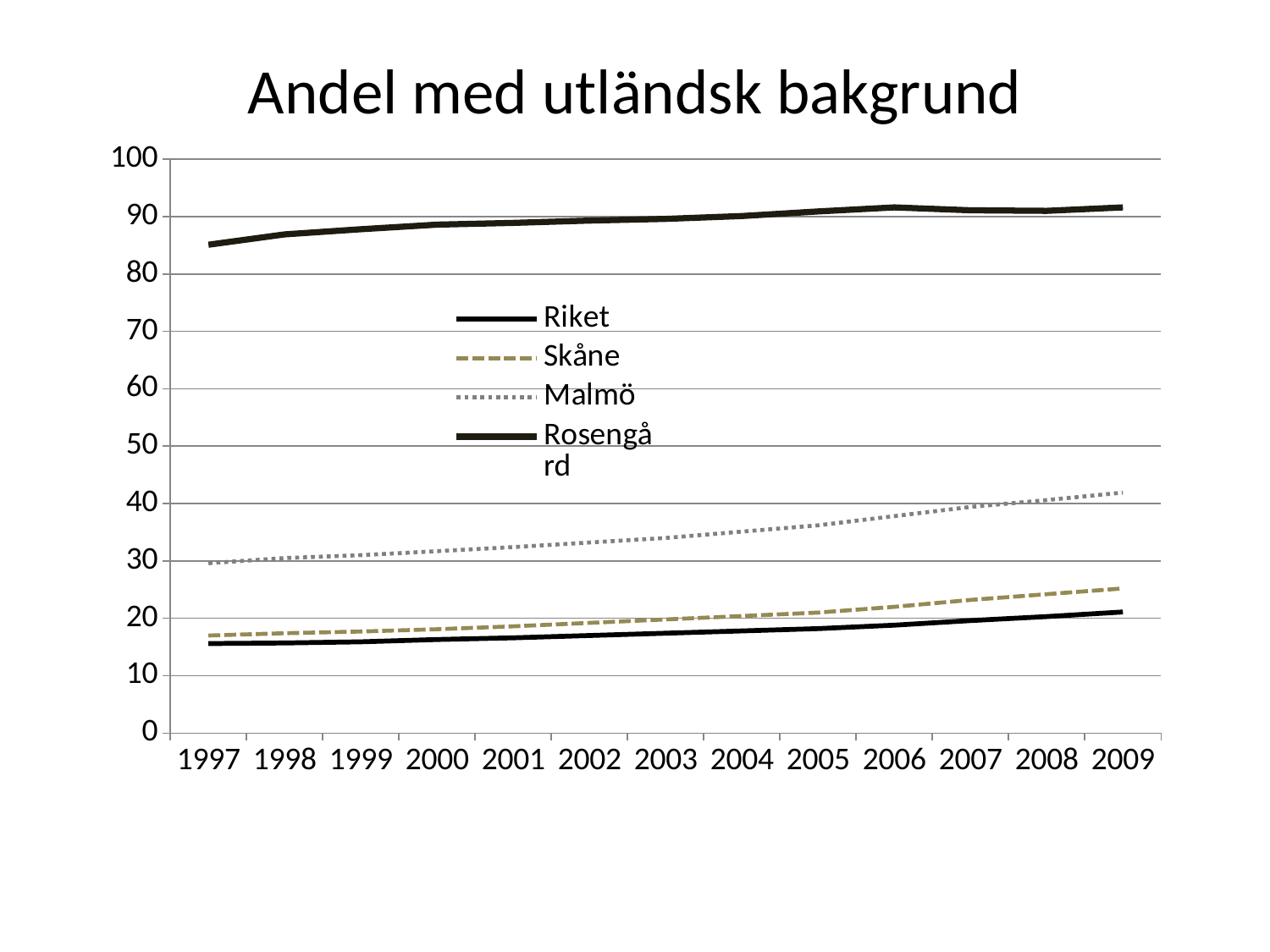
Does the Malmö line rise or fall from 1997 to 2009? rise What is the title of the chart? Andel med utländsk bakgrund How many years are shown on the x axis? 13 What kind of chart is shown on the slide? line chart Which series is drawn with a dotted line? Malmö Is the value for Riket in 1997 greater or less than 20? less In 2005, which is larger: the value for Malmö or the value for Skåne? Malmö Is the value for Skåne in 2009 greater or less than 20? greater Which series has the lowest values throughout the chart? Riket Is the value for Rosengård in 1997 greater or less than 80? greater Which series has the highest values throughout the chart? Rosengård How many series does the legend list? 4